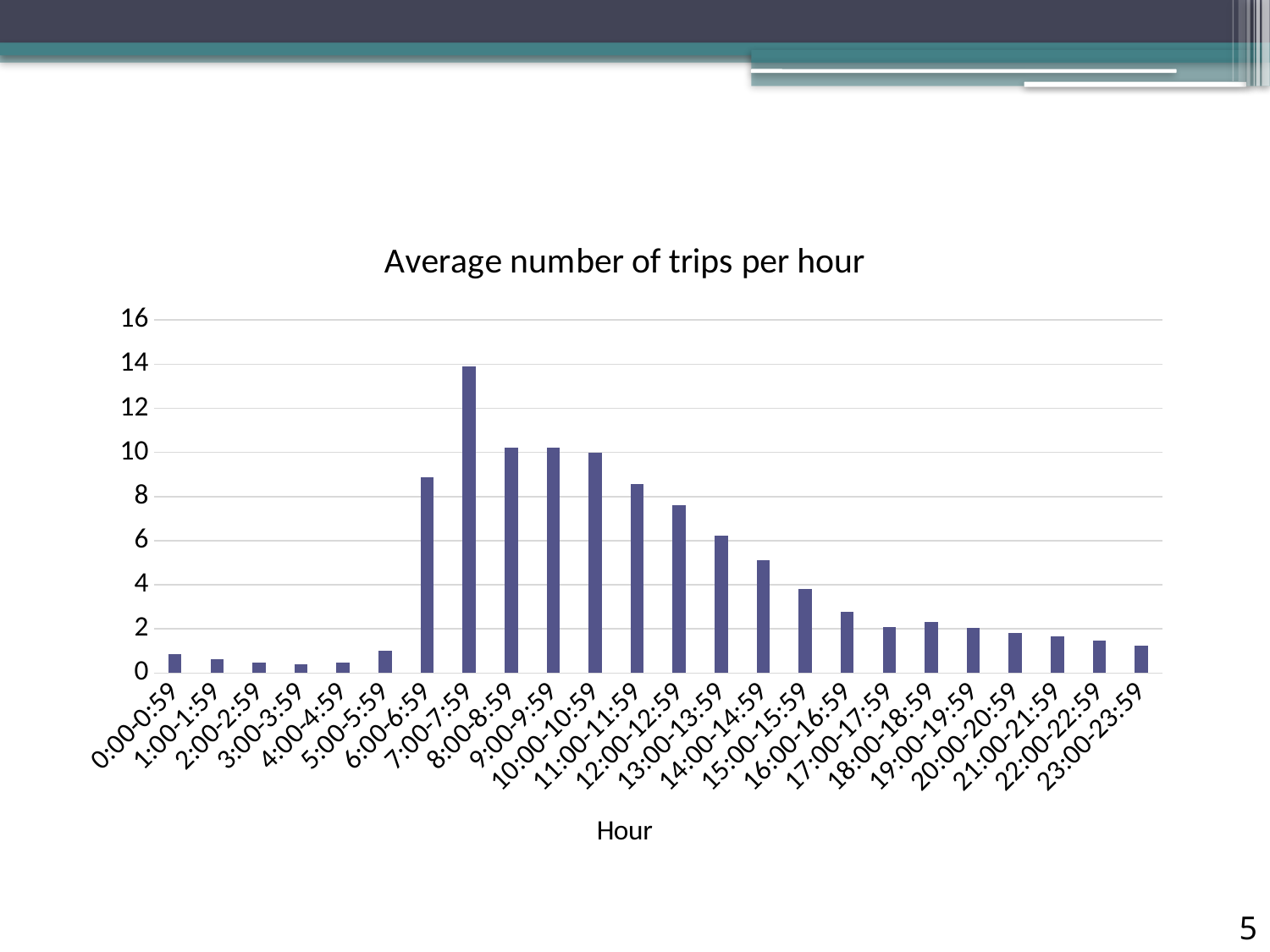
What type of chart is shown on the slide? bar chart Do the values rise or fall along the x axis from 7:00-7:59 to 23:00-23:59? fall Is the value for 7:00-7:59 greater or less than 12? greater Which hour has the highest average number of trips? 7:00-7:59 How many hour categories are plotted on the x axis? 24 Is the value for 6:00-6:59 greater or less than 8? greater What is the label of the x axis? Hour Which is larger, the value for 8:00-8:59 or the value for 12:00-12:59? 8:00-8:59 What is the title of the chart? Average number of trips per hour Is the value for 23:00-23:59 greater or less than 2? less